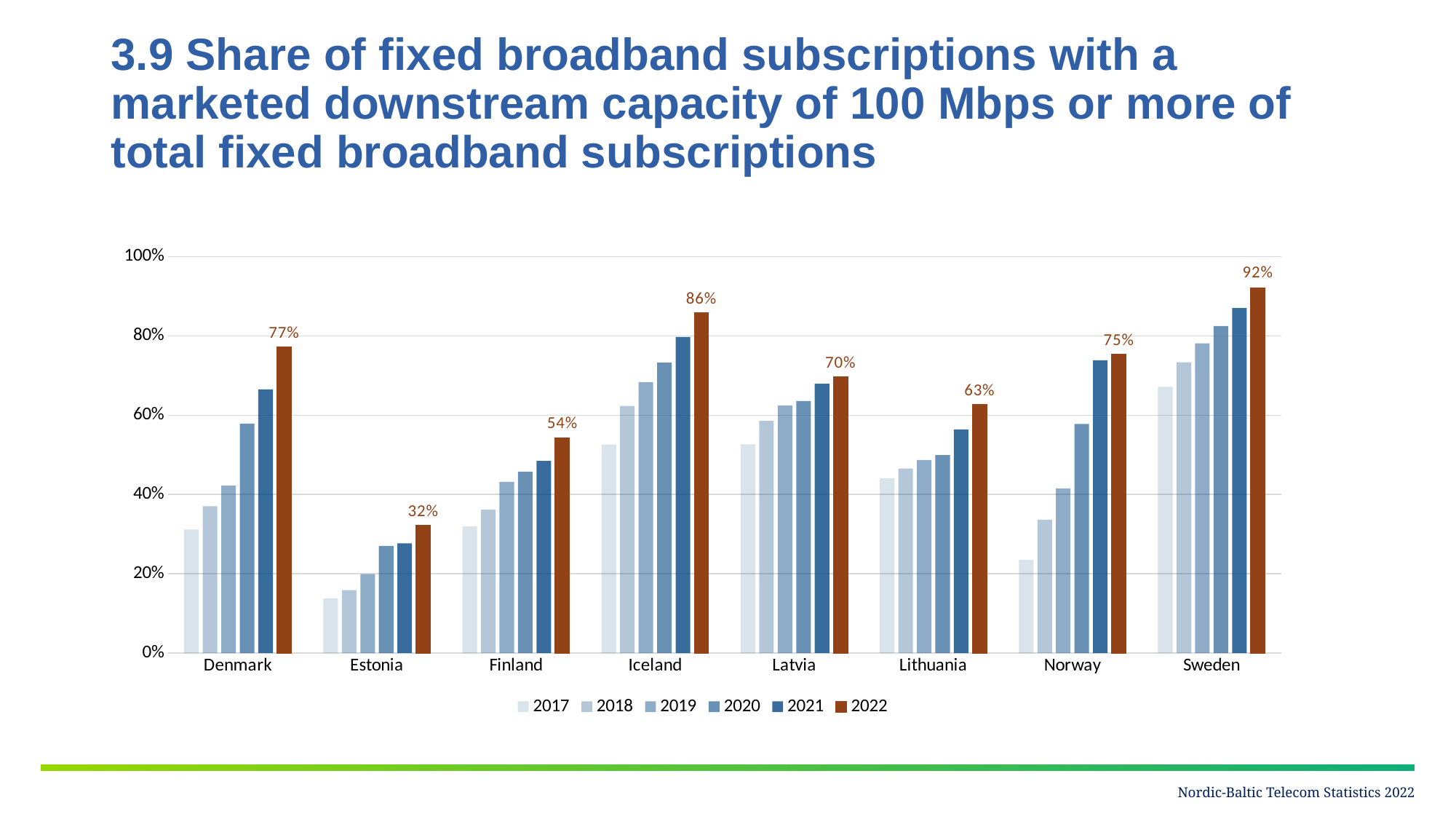
What is the 2022 value for Sweden? 92% What is the 2022 value for Iceland? 86% What is the 2022 value for Estonia? 32% Is the 2017 value for Norway greater or less than 40%? less What kind of chart is shown on the slide? Bar chart What is the difference between the 2022 values for Denmark and Finland? 23% Which has a larger 2022 value, Latvia or Lithuania? Latvia Which country has the lowest 2022 value? Estonia How many countries are shown on the x axis? 8 Which country has the highest 2022 value? Sweden How many series does the legend list? 6 Is the 2021 value for Iceland greater or less than 60%? greater